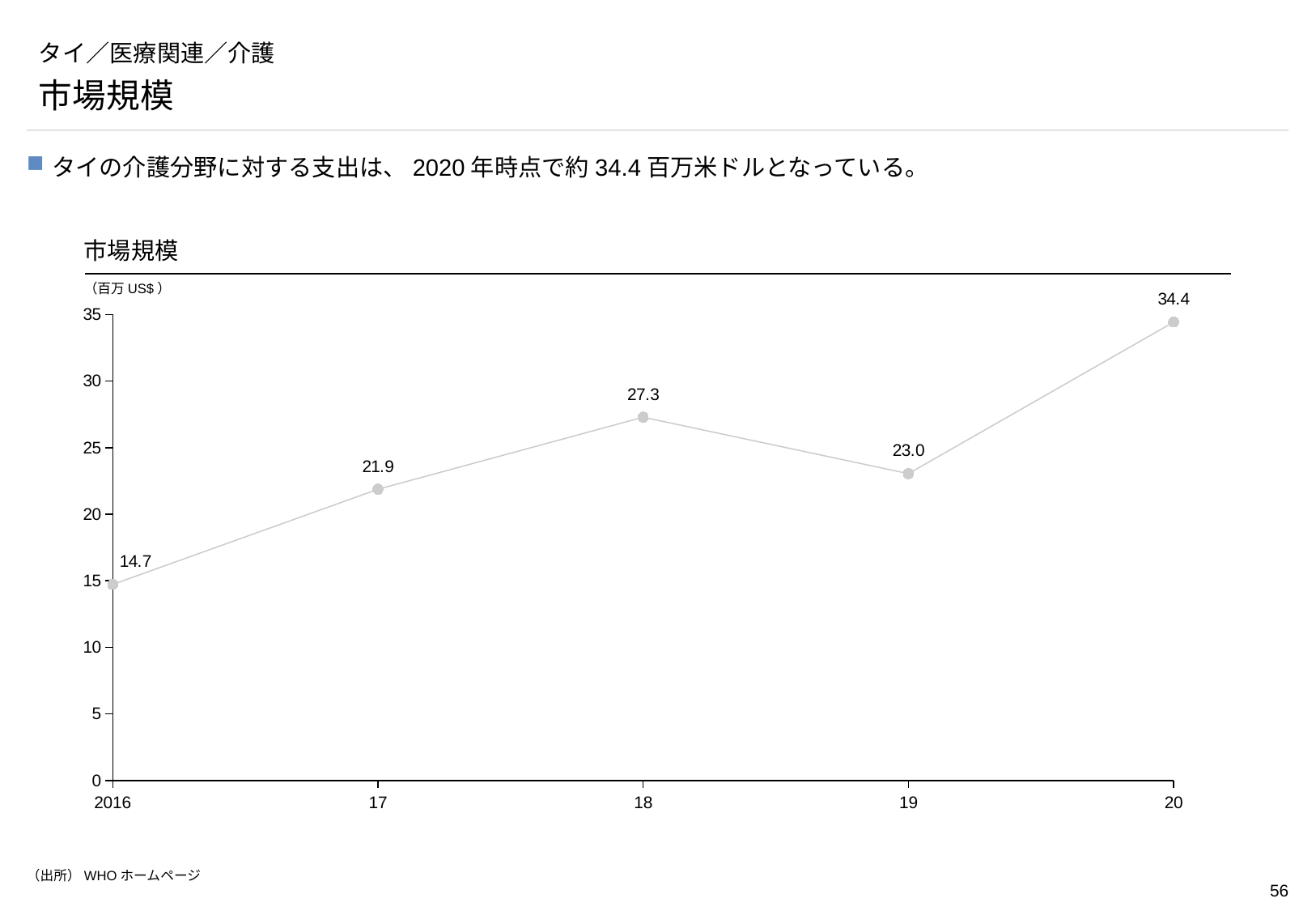
Is the value for 17 greater or less than 20? greater What is the difference between the values for 18 and 17? 5.4 How many data points are plotted on the chart? 5 What is the value for 2016? 14.7 What is the value for 18? 27.3 Which is larger, the value for 18 or the value for 19? 18 What kind of chart is shown on the slide? line chart What unit is shown for the chart's values? 百万 US$ What is the difference between the values for 20 and 19? 11.4 Which year has the lowest value? 2016 Which year has the highest value? 20 What is the value for 19? 23.0